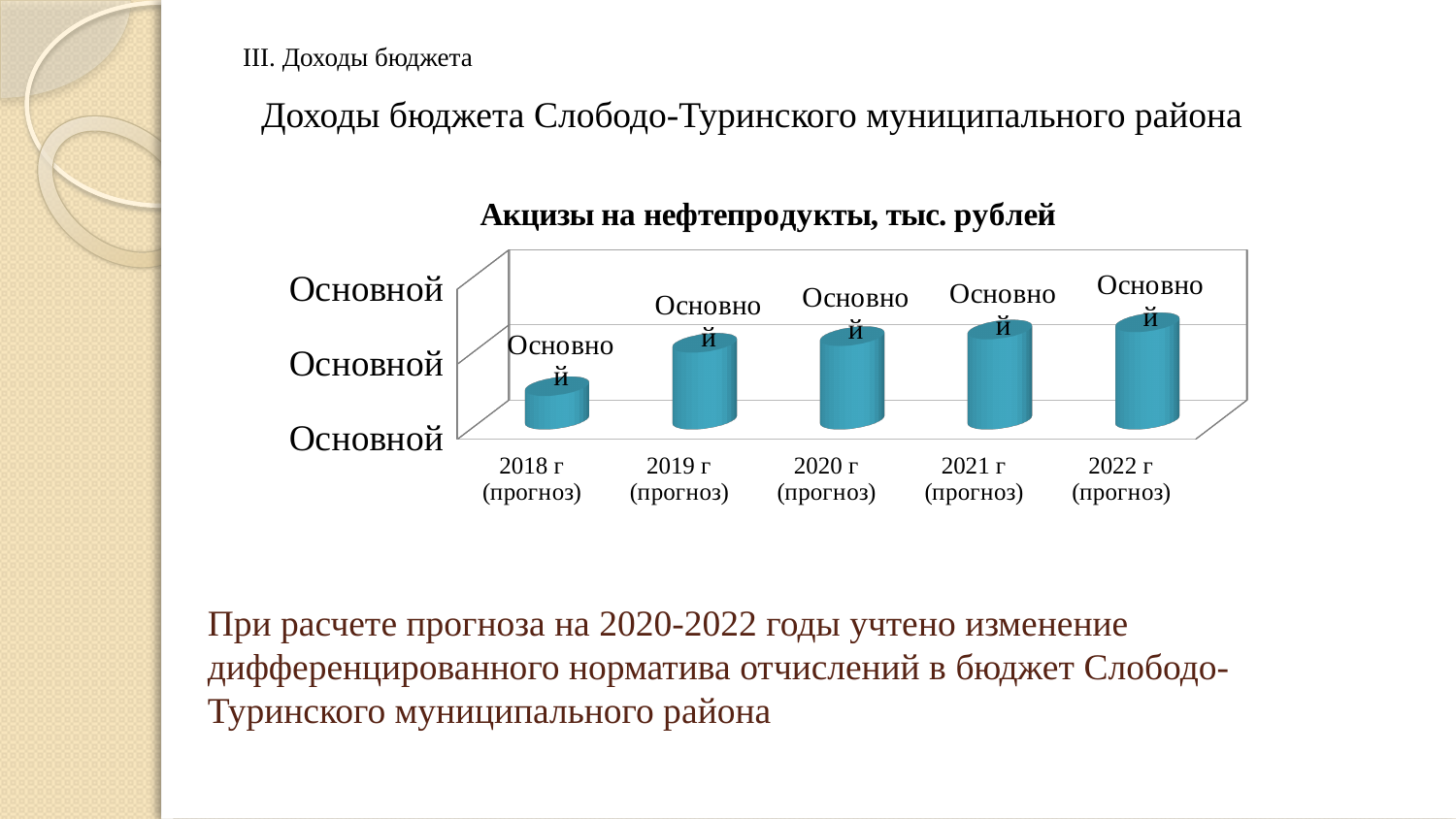
Do the values rise or fall from 2018 to 2022 along the x axis? Rise What is the title of the chart? Акцизы на нефтепродукты, тыс. рублей How many categories (years) are plotted on the chart? 5 What kind of chart is shown on the slide? Bar chart Which category has the lowest bar on the chart? 2018 г (прогноз) In what units are the values on the chart expressed, according to the chart title? тыс. рублей What is the label of the first category on the x axis? 2018 г (прогноз) Which is larger, the bar for 2018 г (прогноз) or the bar for 2019 г (прогноз)? 2019 г (прогноз) Which is larger, the bar for 2018 г (прогноз) or the bar for 2022 г (прогноз)? 2022 г (прогноз) Which category has the highest bar on the chart? 2022 г (прогноз)